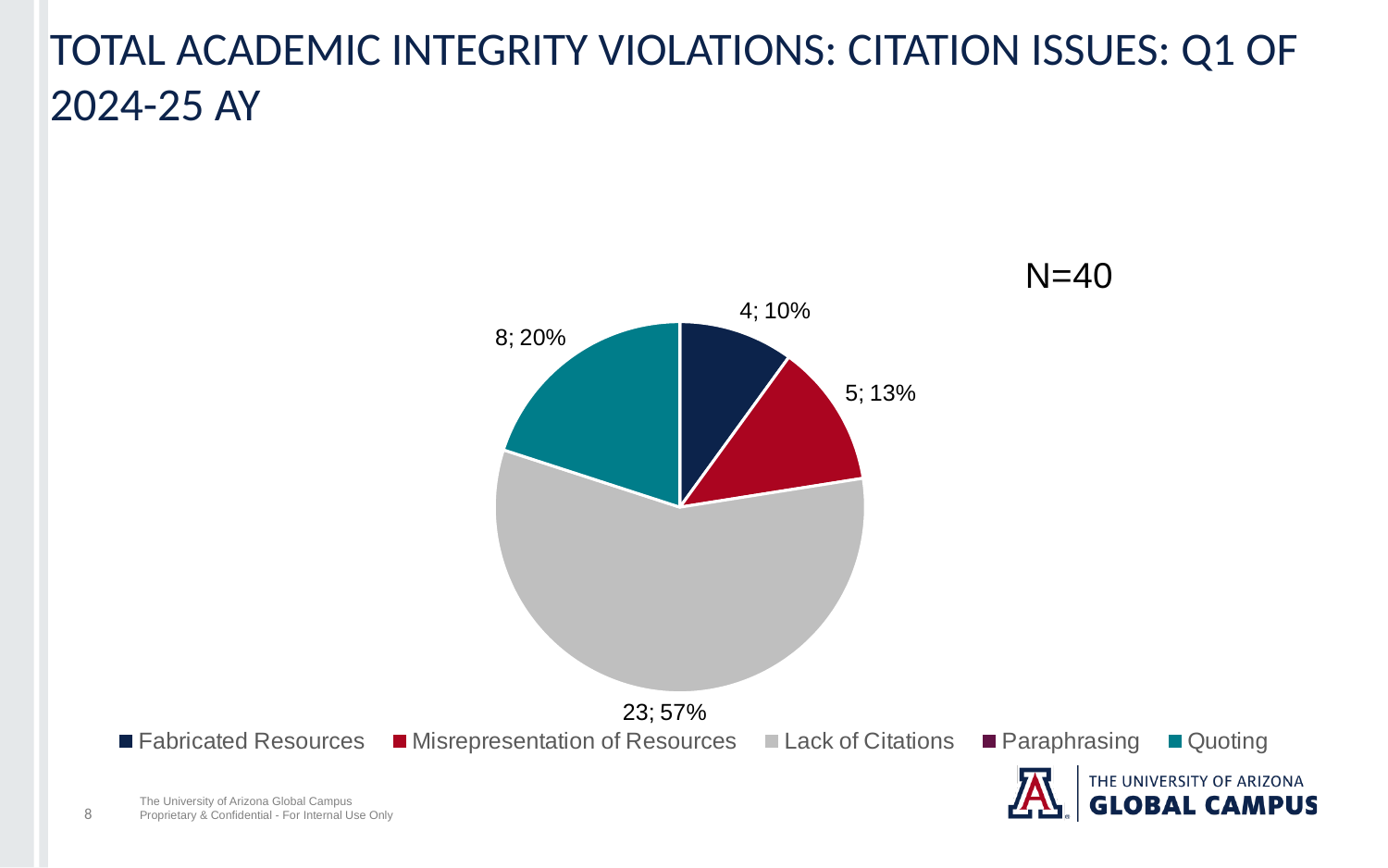
What percentage of the pie does Lack of Citations represent? 57% What total N is stated on the slide for the chart? N=40 Which category has the largest slice of the pie? Lack of Citations How many violations are attributed to Lack of Citations? 23 How many violations are attributed to Fabricated Resources? 4 What kind of chart is shown on the slide? pie chart What is the difference in violations between Lack of Citations and Quoting? 15 How many violations are attributed to Quoting? 8 How many categories does the legend list? 5 What share of the pie does Quoting represent? 20% Which category has more violations, Quoting or Misrepresentation of Resources? Quoting What share of the pie does Misrepresentation of Resources represent? 13%